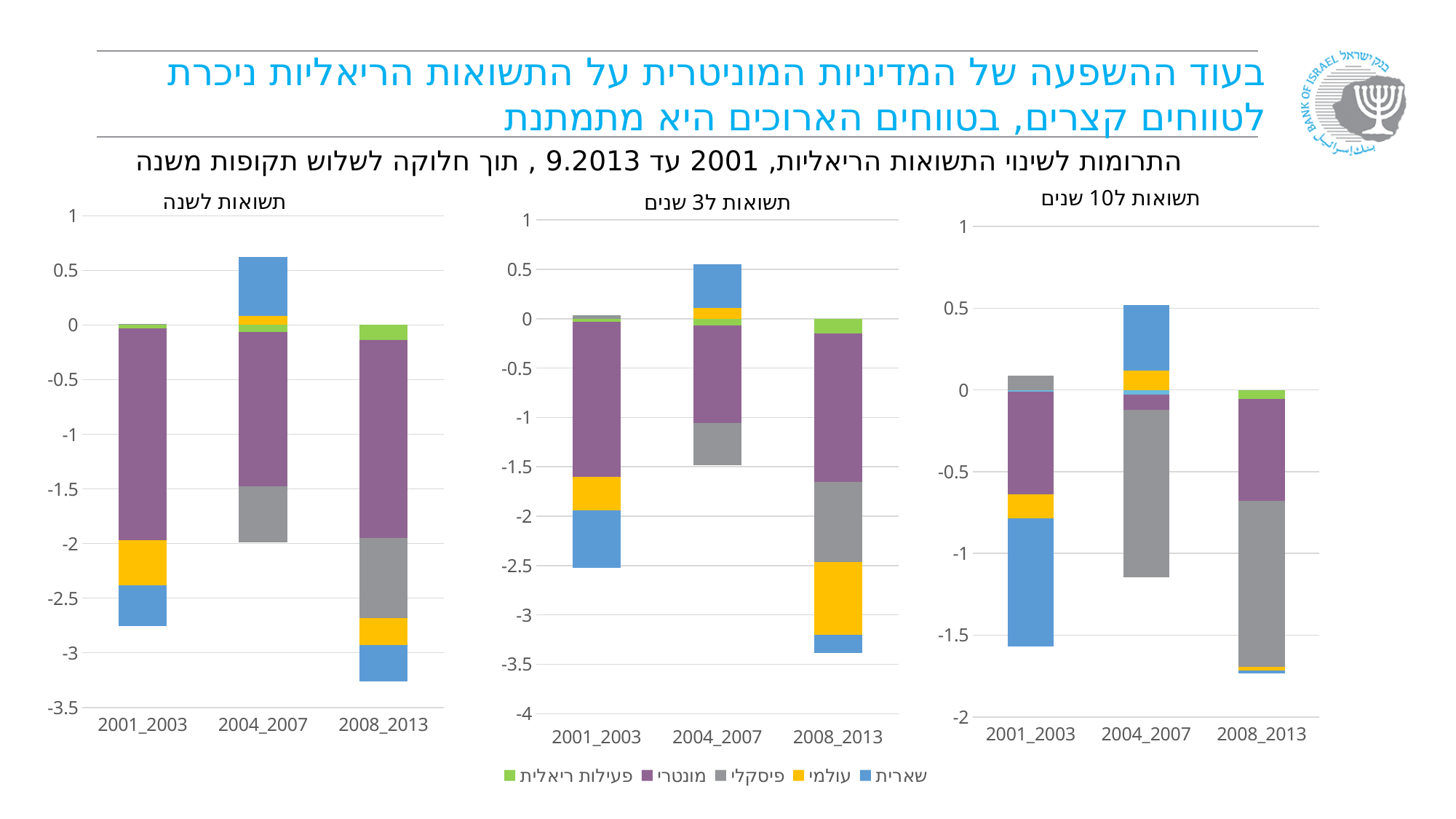
In the left chart (תשואות לשנה), is the bottom of the 2001_2003 stacked bar greater or less than -2.5? less In the middle chart (תשואות ל3 שנים), is the top of the 2004_2007 stacked bar greater or less than 0.5? greater In the left chart (תשואות לשנה), is the top of the 2004_2007 stacked bar greater or less than 0.5? greater In the right chart (תשואות ל10 שנים), which series has the largest segment in the 2008_2013 bar? פיסקלי What kind of chart is the left chart titled תשואות לשנה? bar chart According to the legend, which colour represents the series מונטרי? purple How many periods are shown on the x axis of the middle chart (תשואות ל3 שנים)? 3 How many series does the shared legend at the bottom of the slide list? 5 In the left chart (תשואות לשנה), which period has the largest positive portion above zero? 2004_2007 In the middle chart (תשואות ל3 שנים), which period's stacked bar reaches the lowest value? 2008_2013 What is the title of the right chart? תשואות ל10 שנים